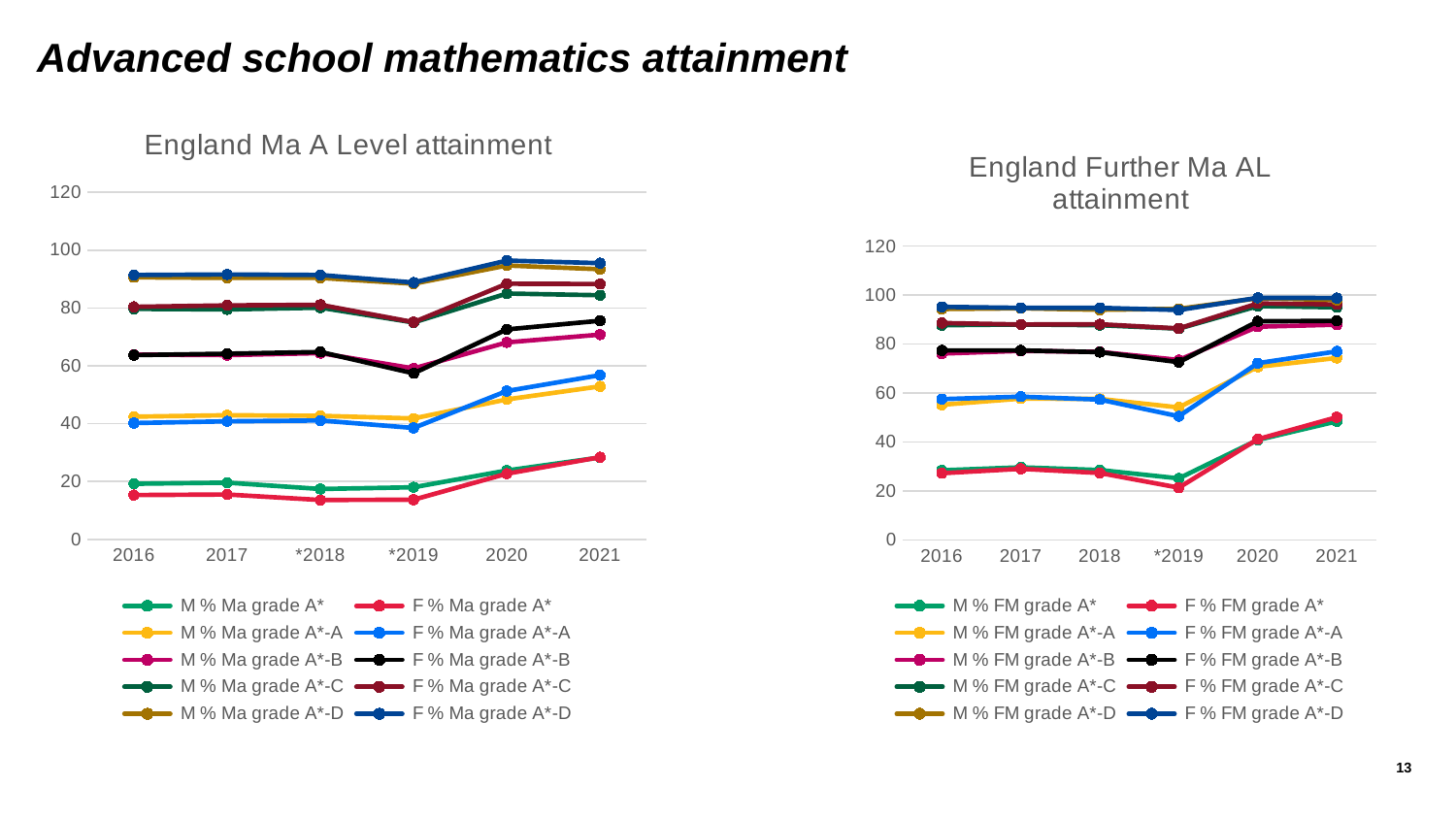
What kind of chart is the 'England Ma A Level attainment' chart? line chart In the 'England Further Ma AL attainment' chart, which year has the lowest value for F % FM grade A*-A? *2019 How many years are shown on the x axis of the 'England Ma A Level attainment' chart? 6 In the 'England Ma A Level attainment' chart, does the M % Ma grade A*-A series rise or fall from *2019 to 2021? rise In the 'England Ma A Level attainment' chart, which year has the highest value for F % Ma grade A*? 2021 In the 'England Ma A Level attainment' chart, is the value for F % Ma grade A* in 2016 greater or less than 20? less In the 'England Further Ma AL attainment' chart, is the value for F % FM grade A*-B in *2019 greater or less than 60? greater How many series does the legend of the 'England Further Ma AL attainment' chart list? 10 In the 'England Further Ma AL attainment' chart, does the F % FM grade A*-A series rise or fall from 2016 to *2019? fall In the 'England Ma A Level attainment' chart, is the value for M % Ma grade A*-A in 2021 greater or less than 40? greater In the 'England Further Ma AL attainment' chart, which is larger in 2016: M % FM grade A*-B or M % FM grade A*-C? M % FM grade A*-C